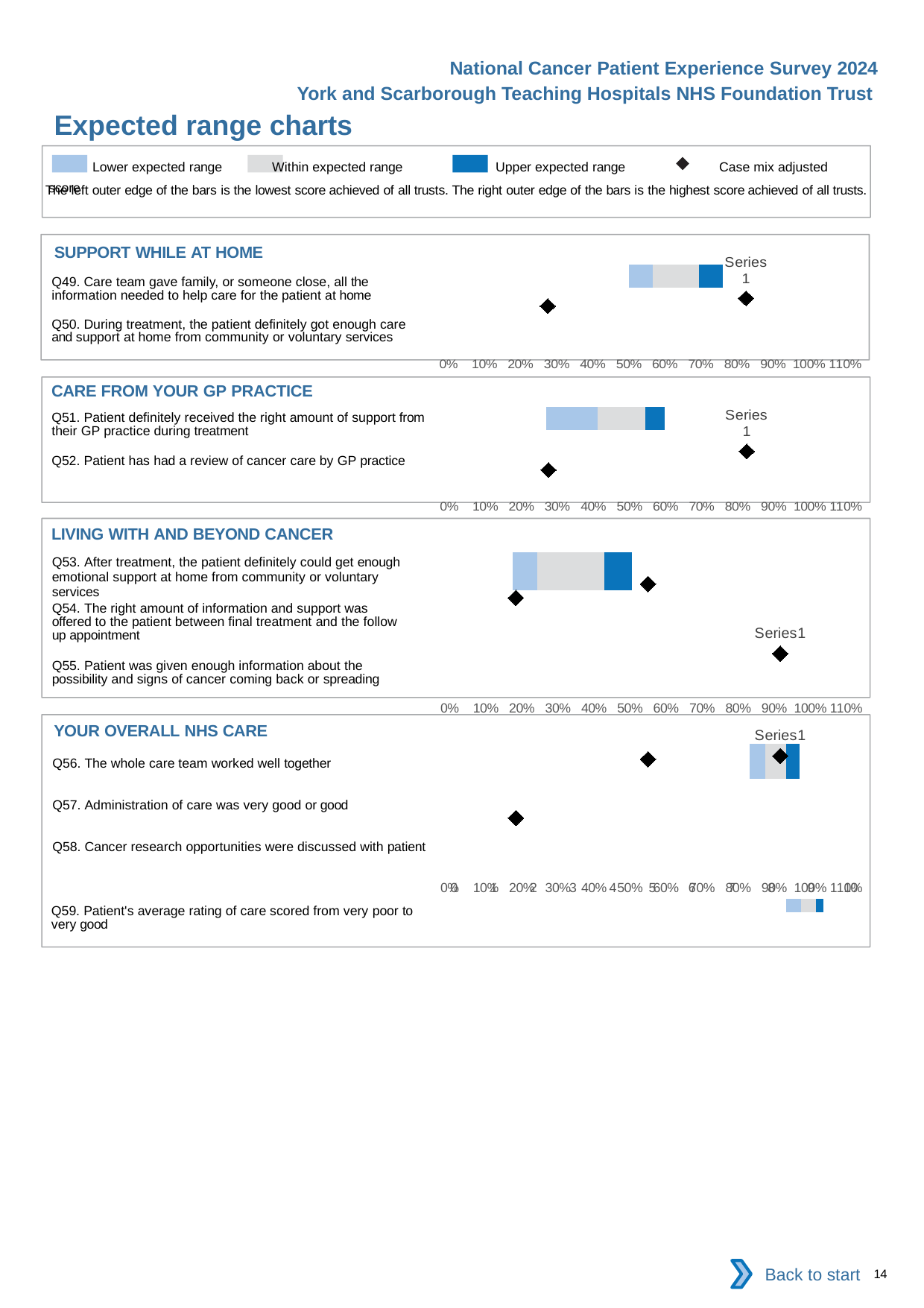
In the CARE FROM YOUR GP PRACTICE chart, is the diamond marker below the 'Series 1' label greater or less than 70%? greater According to the legend, what does the dark blue colour represent? Upper expected range In the LIVING WITH AND BEYOND CANCER chart, is the diamond marker below the 'Series1' label greater or less than 80%? greater How many diamond markers are plotted in the SUPPORT WHILE AT HOME chart? 2 According to the legend, what does the black diamond marker represent? Case mix adjusted score In the YOUR OVERALL NHS CARE chart, is the leftmost diamond marker greater or less than 30%? less How many questions are listed in the LIVING WITH AND BEYOND CANCER section? 3 How many questions are listed in the SUPPORT WHILE AT HOME section? 2 What kind of chart is used for the expected range charts on this slide? bar chart In the CARE FROM YOUR GP PRACTICE chart, which diamond marker is further to the right: the one below the 'Series 1' label or the lower-left one? the one below the 'Series 1' label